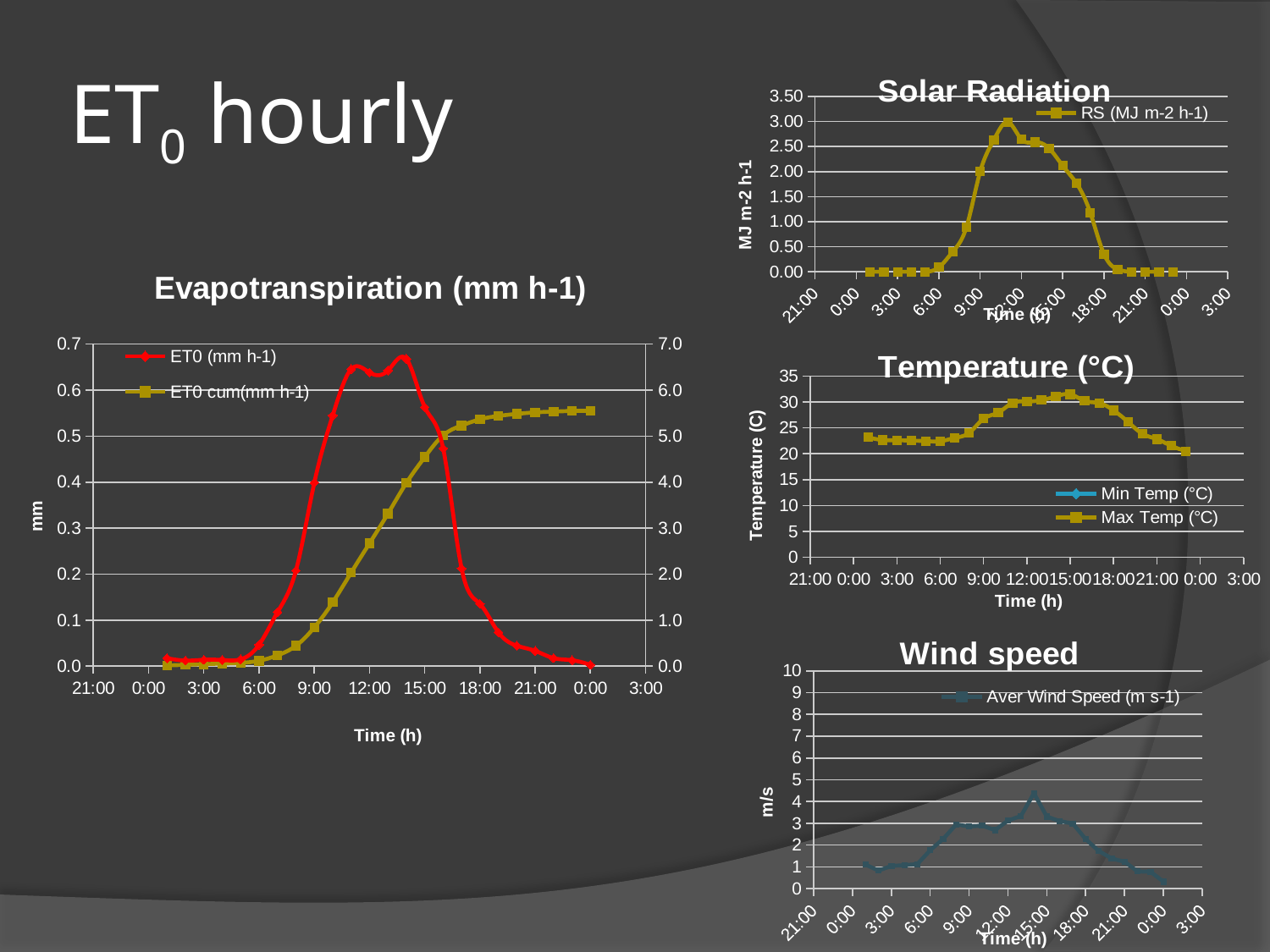
In the Temperature (°C) chart, how many series does the legend list? 2 In the Evapotranspiration (mm h-1) chart, is the final value of ET0 cum(mm h-1) at 0:00 greater or less than 5.0 on the right axis? greater In the Evapotranspiration (mm h-1) chart, is the peak value of ET0 (mm h-1) greater or less than 0.6? greater In the Solar Radiation chart, is the peak value of RS (MJ m-2 h-1) greater or less than 2.50? greater In the Solar Radiation chart, what is the value of RS (MJ m-2 h-1) at 3:00? 0.00 In the Solar Radiation chart, how many series does the legend list? 1 In the Evapotranspiration (mm h-1) chart, does the ET0 cum(mm h-1) series rise or fall along the x axis? rise What kind of chart is the Evapotranspiration (mm h-1) chart? line chart How many charts are shown on the slide? 4 In the Evapotranspiration (mm h-1) chart, how many series does the legend list? 2